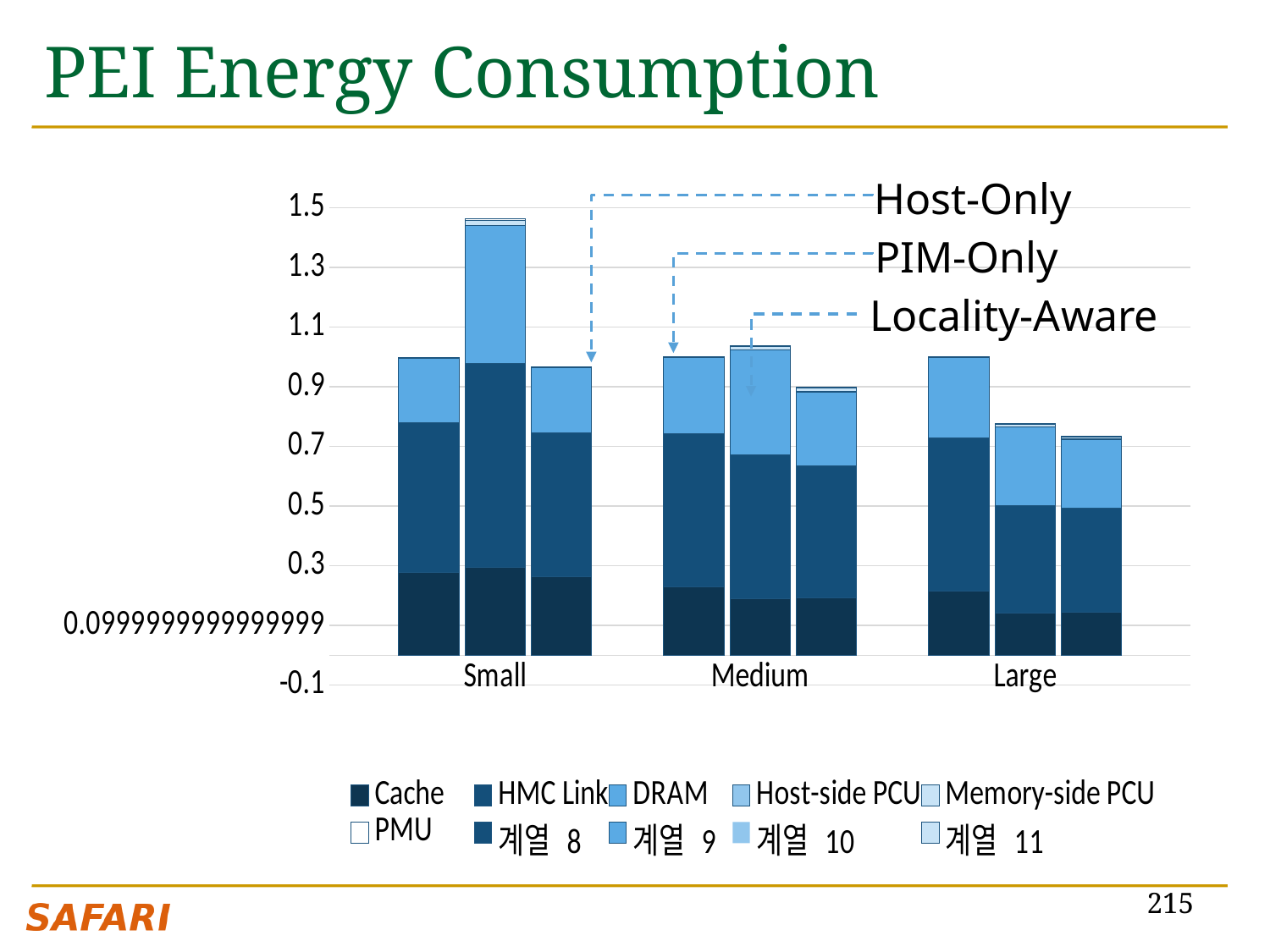
How many series does the chart's legend list? 10 Is the value of the PIM-Only bar for Small greater or less than 1.3? greater For the Small category, which bar is taller: PIM-Only or Locality-Aware? PIM-Only Which of the three bar groups (Small, Medium, Large) contains the tallest bar in the chart? Small For the Large category, which bar is taller: Host-Only or PIM-Only? Host-Only Do the PIM-Only bars rise or fall going from Small to Large along the x axis? fall What kind of chart is shown on the slide? stacked bar chart How many categories are shown on the x axis of the chart? 3 What is the title of the chart on the slide? PEI Energy Consumption Is the value of the PIM-Only bar for Large greater or less than 0.9? less Is the value of the Locality-Aware bar for Small greater or less than 1.1? less